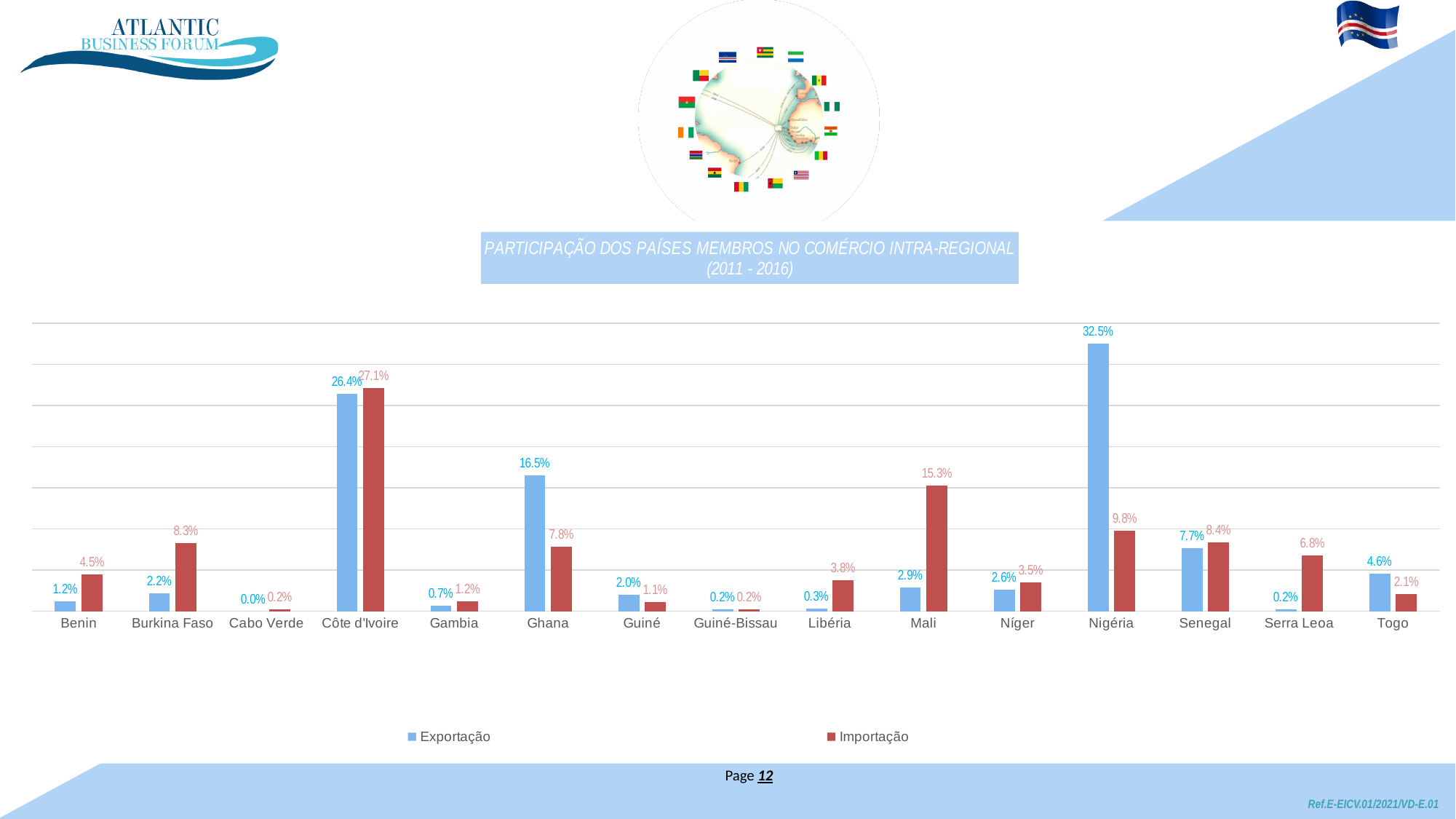
What is the Importação value for Serra Leoa? 6.8% What is the Exportação value for Nigéria? 32.5% What is the Exportação value for Ghana? 16.5% How many series does the legend list? 2 What kind of chart is shown on the slide? Bar chart Which country has the highest Importação value? Côte d'Ivoire What is the Importação value for Mali? 15.3% What colour are the Importação bars? Red Which is larger for Ghana, Exportação or Importação? Exportação What is the difference between the Importação and Exportação values for Côte d'Ivoire? 0.7% Which country has the lowest Exportação value? Cabo Verde How many countries are shown on the x axis? 15